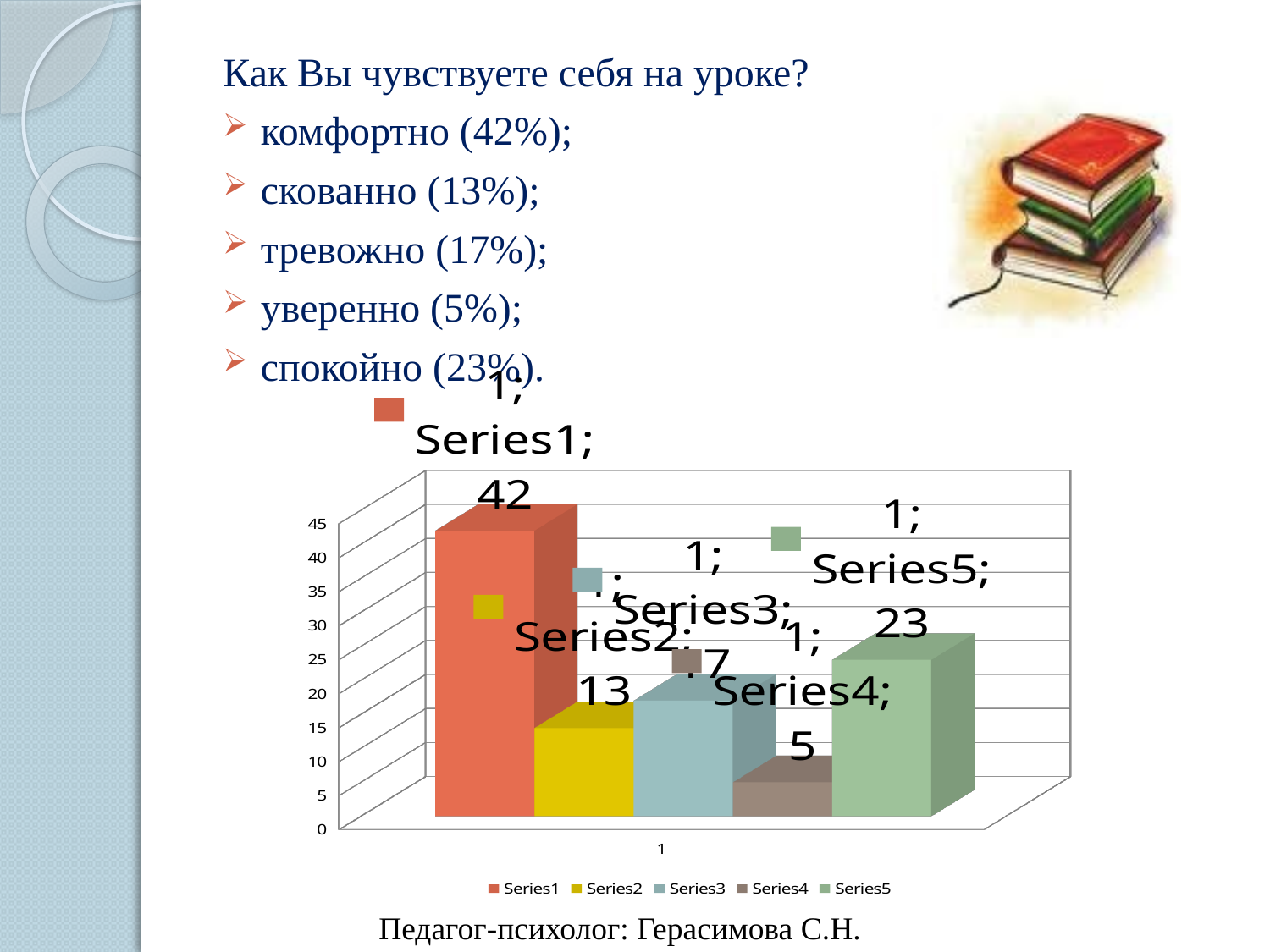
What is the value of Series2 in the bar chart? 13 What is the difference between the values of Series1 and Series5? 19 What is the category label shown on the x axis of the chart? 1 What is the value of Series5 in the bar chart? 23 Is the value for Series3 greater or less than 20? less Which series has the lowest value in the bar chart? Series4 What is the value of Series1 in the bar chart? 42 How many series does the legend list? 5 Which series has the highest value in the bar chart? Series1 What kind of chart is shown on the slide? bar chart What is the value of Series4 in the bar chart? 5 Which is larger, the value of Series2 or the value of Series5? Series5